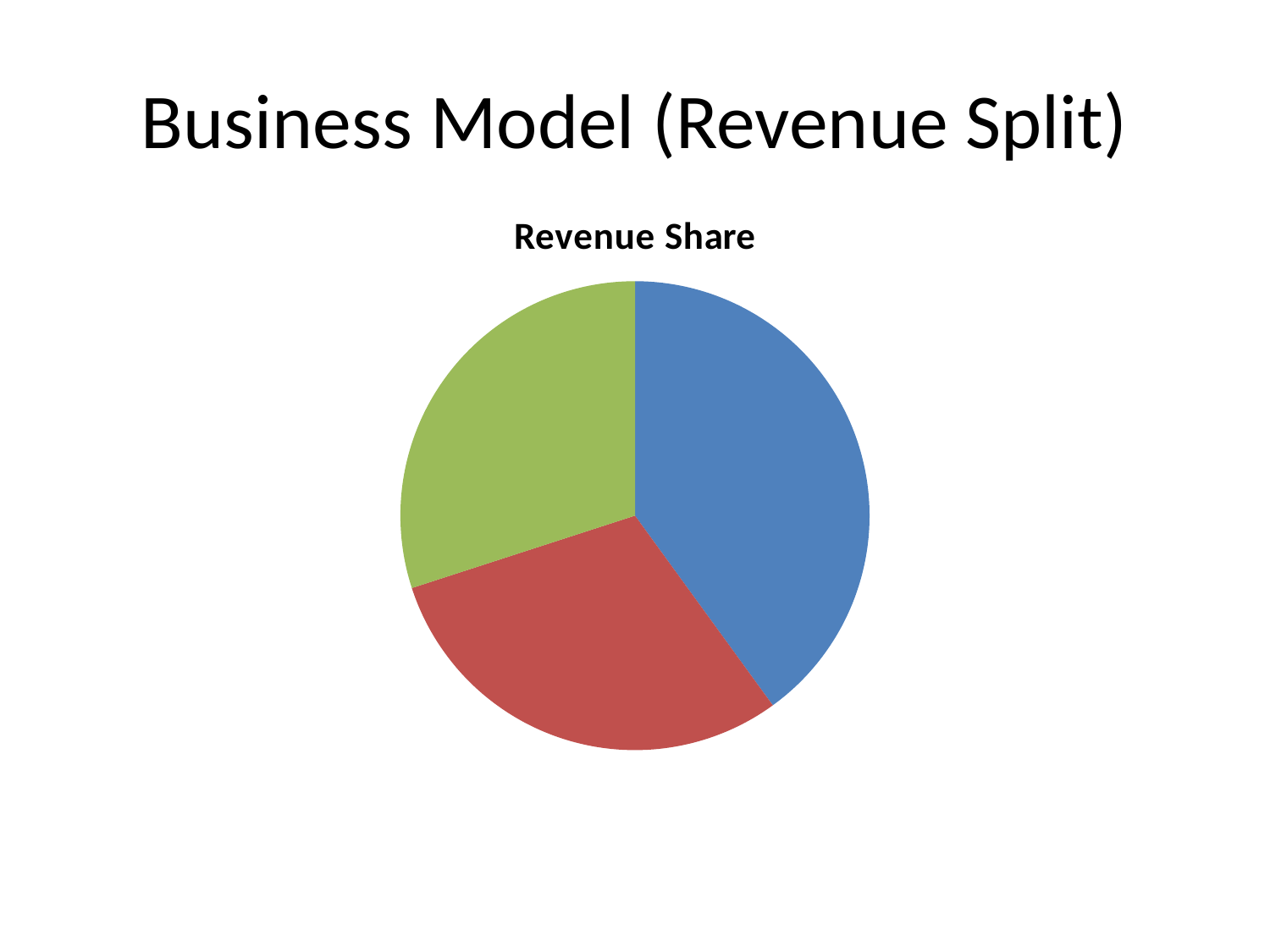
What is the title of the chart on the slide? Revenue Share In the Revenue Share pie chart, is the blue slice larger or smaller than the red slice? larger In the Revenue Share pie chart, is the blue slice larger or smaller than the green slice? larger What colours are the three slices of the Revenue Share pie chart? blue, red and green How many slices does the Revenue Share pie chart have? 3 What kind of chart is shown on the slide? pie chart Which colour slice is the largest in the Revenue Share pie chart? blue